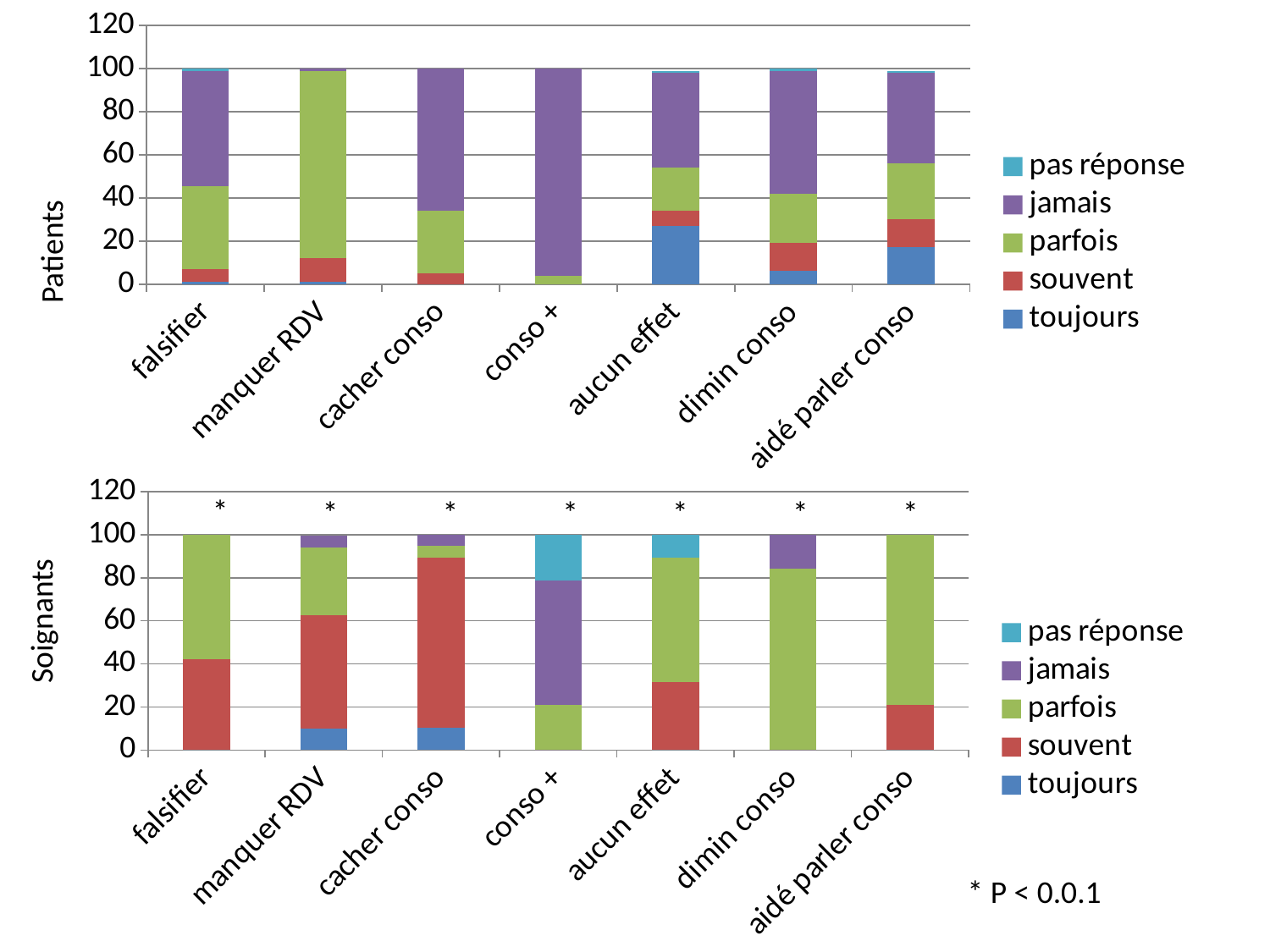
In the bottom chart labelled "Soignants", which category has the larger "souvent" segment, "cacher conso" or "aidé parler conso"? cacher conso In the top chart labelled "Patients", which category has the larger "jamais" segment, "conso +" or "falsifier"? conso + What is the y-axis title of the bottom chart? Soignants In the bottom chart labelled "Soignants", is the "parfois" segment for "dimin conso" greater or less than 60? greater In the bottom chart labelled "Soignants", which category has the larger "jamais" segment, "conso +" or "manquer RDV"? conso + In the top chart labelled "Patients", is the "jamais" segment for "conso +" greater or less than 80? greater How many series does the legend of the top chart labelled "Patients" list? 5 What kind of chart is the top chart labelled "Patients"? stacked bar chart In the bottom chart labelled "Soignants", is the "souvent" segment for "cacher conso" greater or less than 60? greater Which legend entry is shown in light blue in the top chart labelled "Patients"? pas réponse How many categories are shown on the x axis of the bottom chart labelled "Soignants"? 7